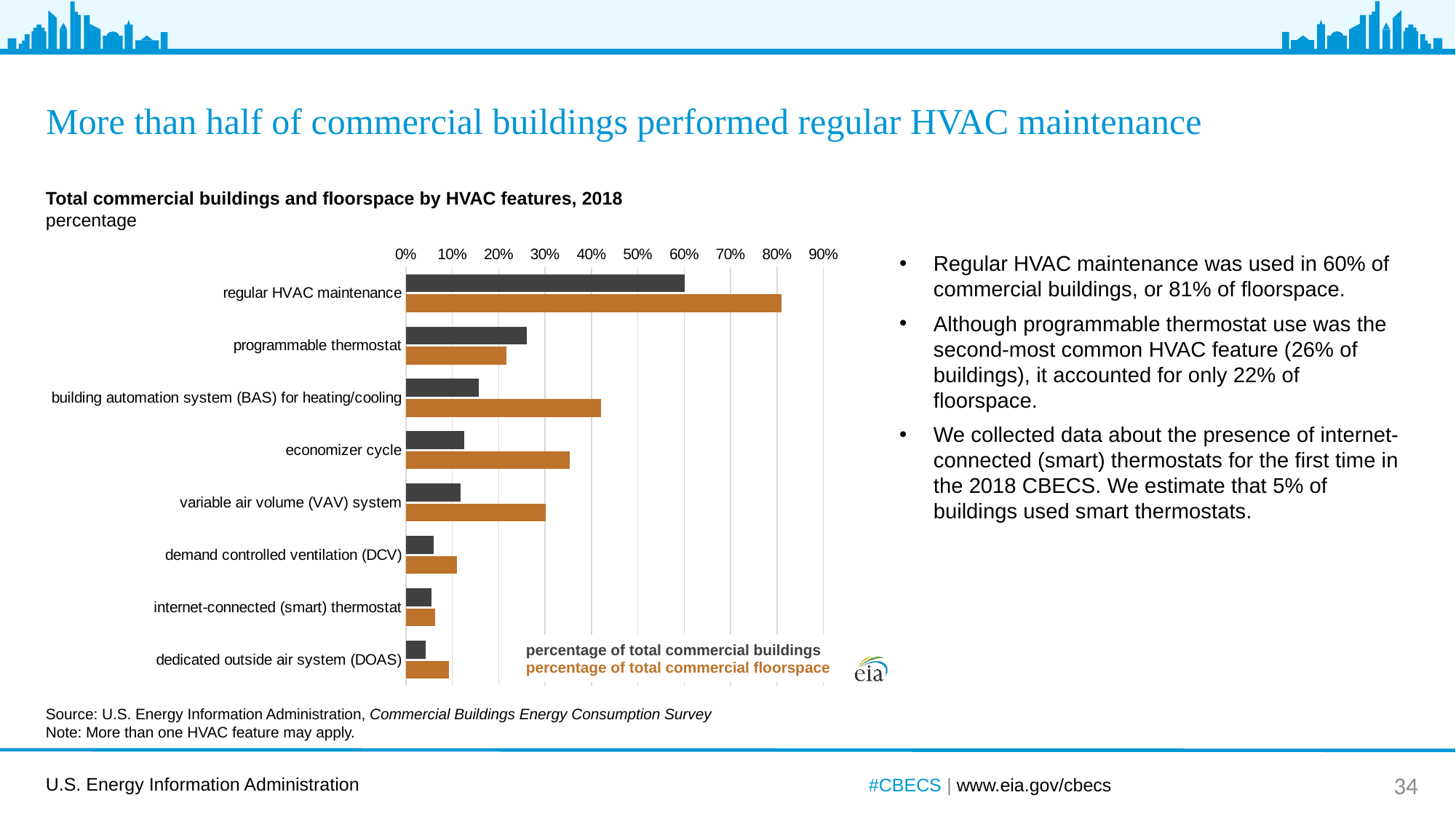
What colour represents the percentage of total commercial floorspace series? orange Is the percentage of total commercial floorspace for regular HVAC maintenance greater or less than 70%? greater How many HVAC feature categories are plotted on the chart? 8 Is the percentage of total commercial floorspace for building automation system (BAS) for heating/cooling greater or less than 30%? greater Going from the top category to the bottom category, do the percentages of total commercial buildings increase or decrease? decrease Which HVAC feature has the lowest percentage of total commercial floorspace? internet-connected (smart) thermostat Is the percentage of total commercial buildings for economizer cycle greater or less than 20%? less What percentage of total commercial buildings performed regular HVAC maintenance? 60% What kind of chart is shown on the slide? bar chart Which HVAC feature has the highest percentage of total commercial buildings? regular HVAC maintenance How many series does the chart's legend list? 2 For building automation system (BAS) for heating/cooling, which is larger: the percentage of total commercial buildings or the percentage of total commercial floorspace? percentage of total commercial floorspace